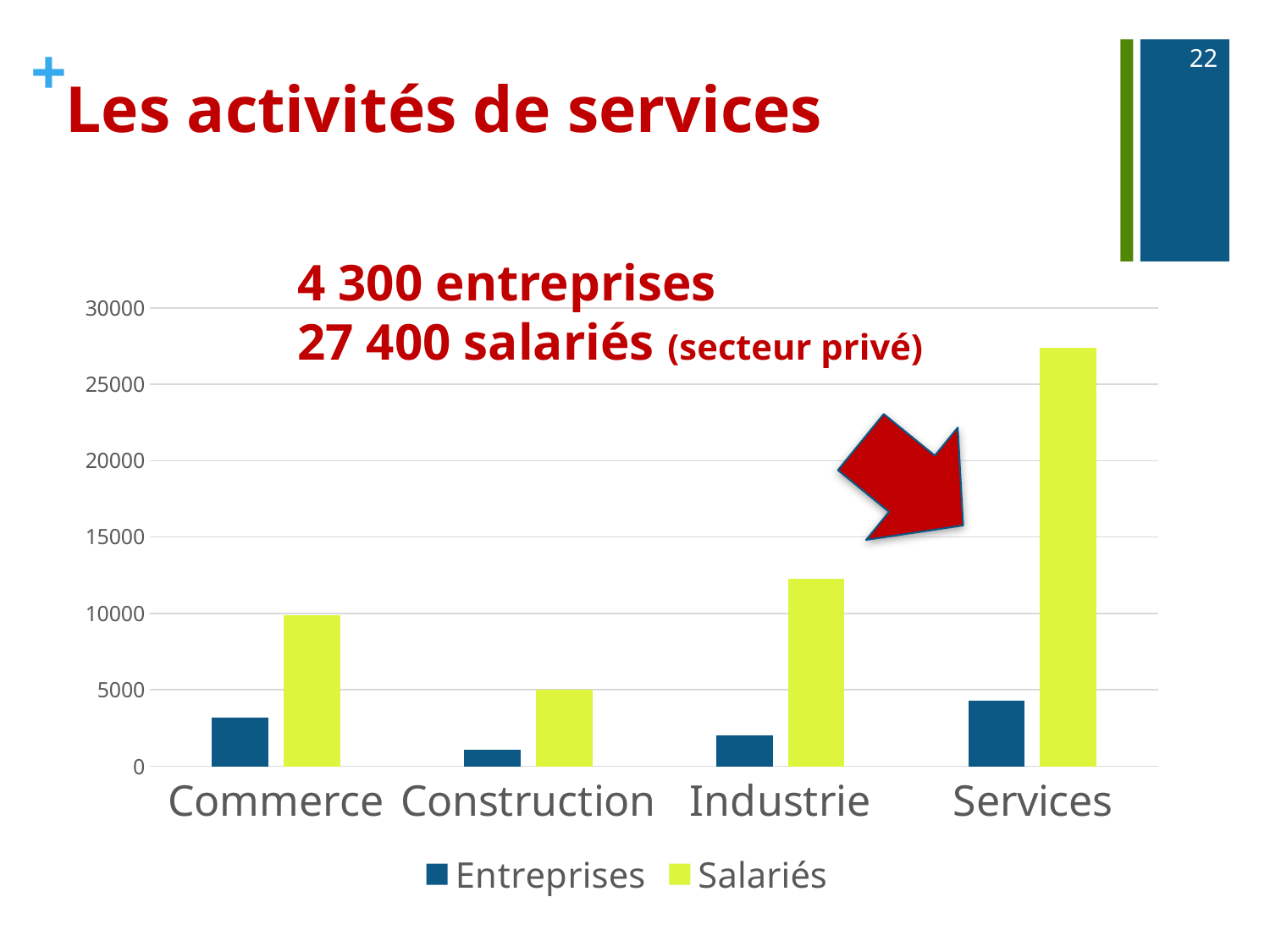
Is the Salariés value for Industrie greater or less than 10000? greater Which category has the lowest Salariés value? Construction Is the Salariés value for Services greater or less than 25000? greater How many categories are shown on the x axis of the chart? 4 Which colour represents the Salariés series in the chart legend? yellow-green Is the Entreprises value for Commerce greater or less than 5000? less Which category has the highest Entreprises value? Services How many series does the chart legend list? 2 Which category has the lowest Entreprises value? Construction Which category has the highest Salariés value? Services What kind of chart is shown on the slide? bar chart Which is larger, the Salariés value for Commerce or for Industrie? Industrie